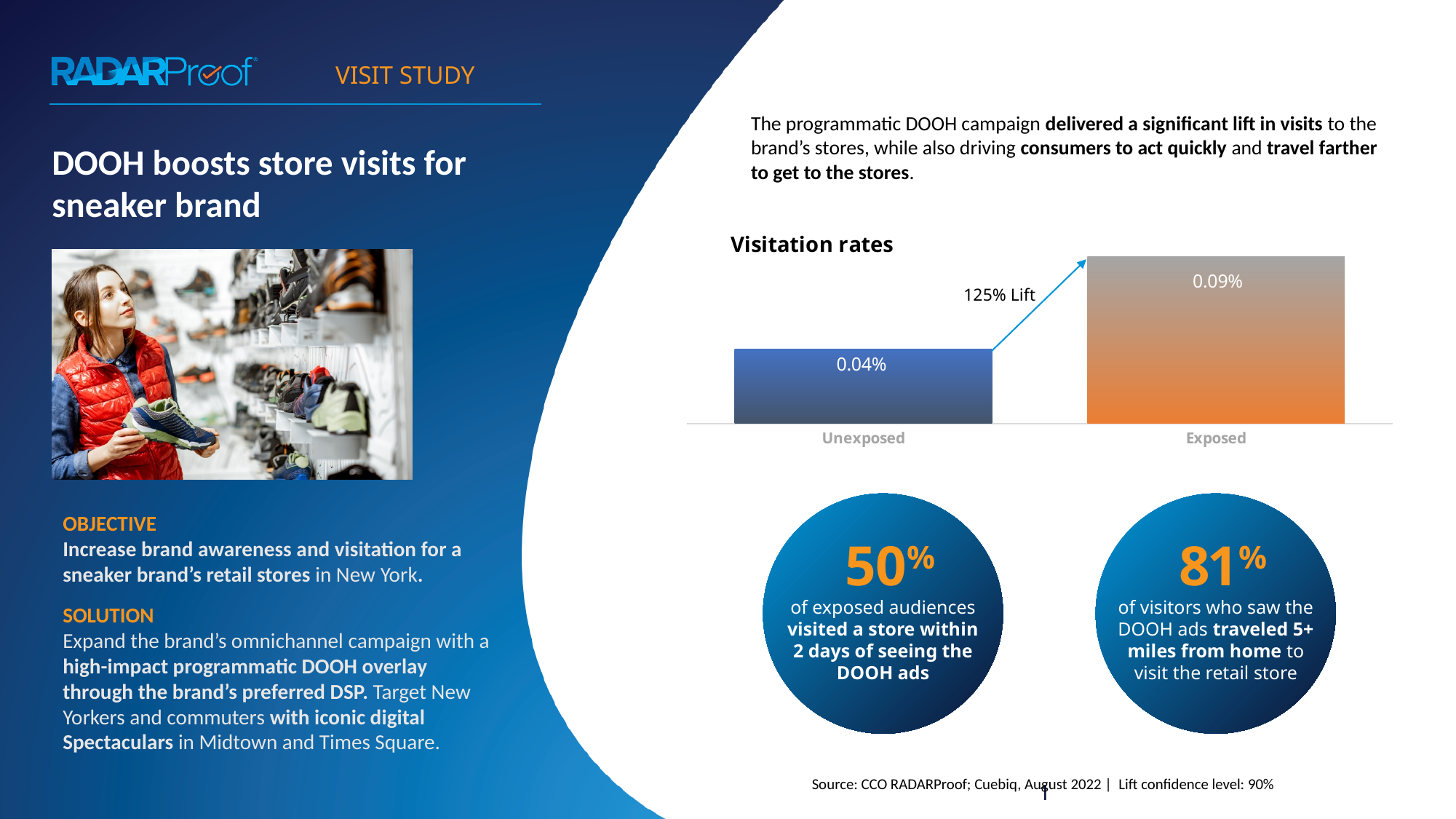
What is the visitation rate for the Unexposed group? 0.04% Is the visitation rate for Exposed larger or smaller than for Unexposed? larger What is the visitation rate for the Exposed group? 0.09% What lift percentage is annotated on the chart between the Unexposed and Exposed bars? 125% Lift What is the difference in visitation rate between the Exposed and Unexposed groups? 0.05% Which category has the higher visitation rate? Exposed How many categories are shown in the Visitation rates chart? 2 Which category has the lower visitation rate? Unexposed What is the title of the chart? Visitation rates What kind of chart is the Visitation rates chart? bar chart